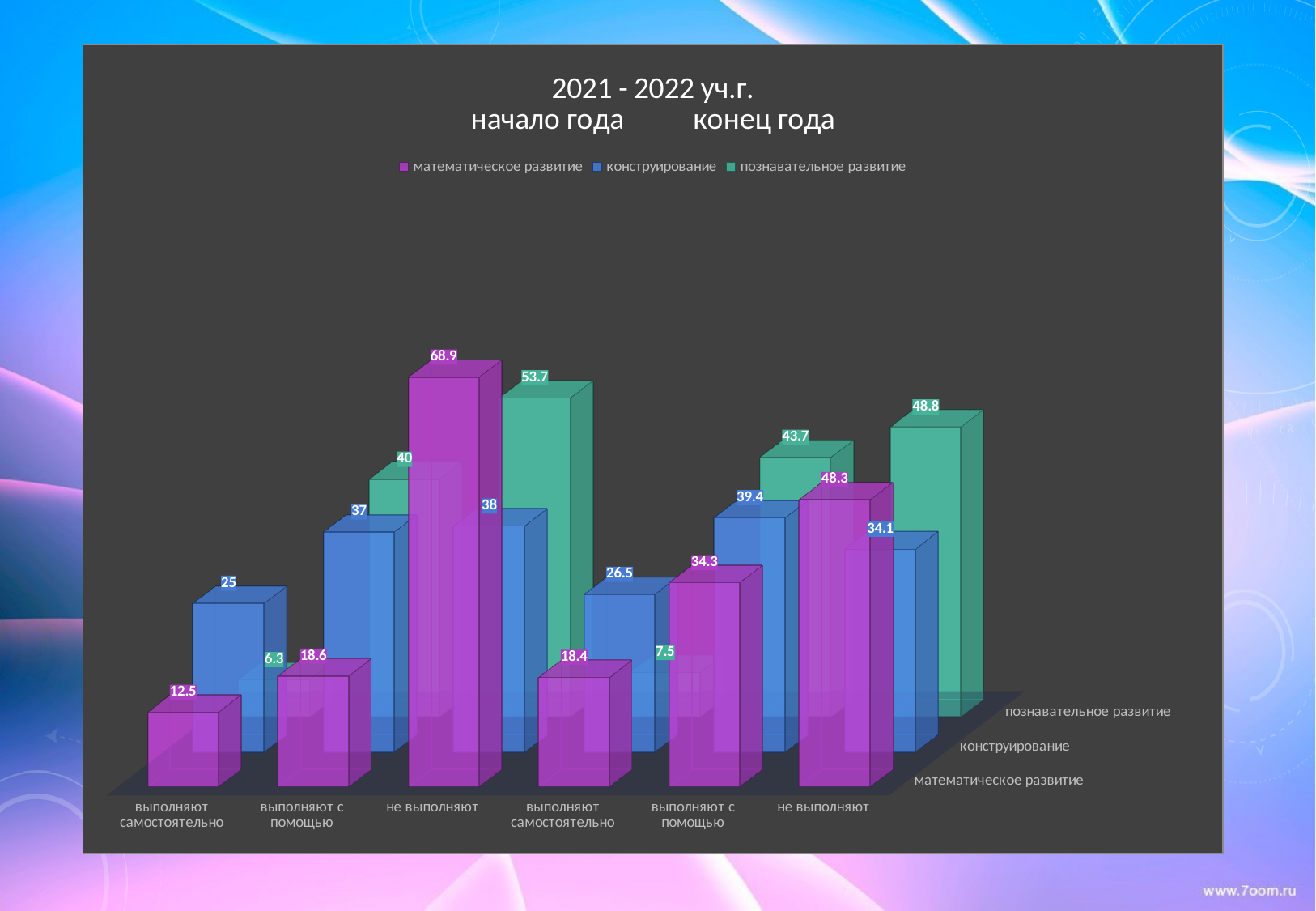
Which series has the highest value for 'не выполняют' at the start of the year (начало года)? математическое развитие What is the value of познавательное развитие for 'не выполняют' at the end of the year (конец года)? 48.8 What kind of chart is shown on the slide? bar chart What is the value of математическое развитие for 'не выполняют' at the start of the year (начало года)? 68.9 Which series has the lowest value for 'выполняют самостоятельно' at the end of the year (конец года)? познавательное развитие What is the difference between the математическое развитие values for 'не выполняют' at the start of the year (68.9) and at the end of the year (48.3)? 20.6 What is the value of конструирование for 'выполняют самостоятельно' at the start of the year (начало года)? 25 What is the value of познавательное развитие for 'выполняют с помощью' at the end of the year (конец года)? 43.7 Which series is shown in green in the legend? познавательное развитие How many category groups are shown along the x axis? 6 How many series does the legend list? 3 Which is larger: конструирование for 'выполняют с помощью' at the start of the year or конструирование for 'выполняют с помощью' at the end of the year? end of the year (39.4)